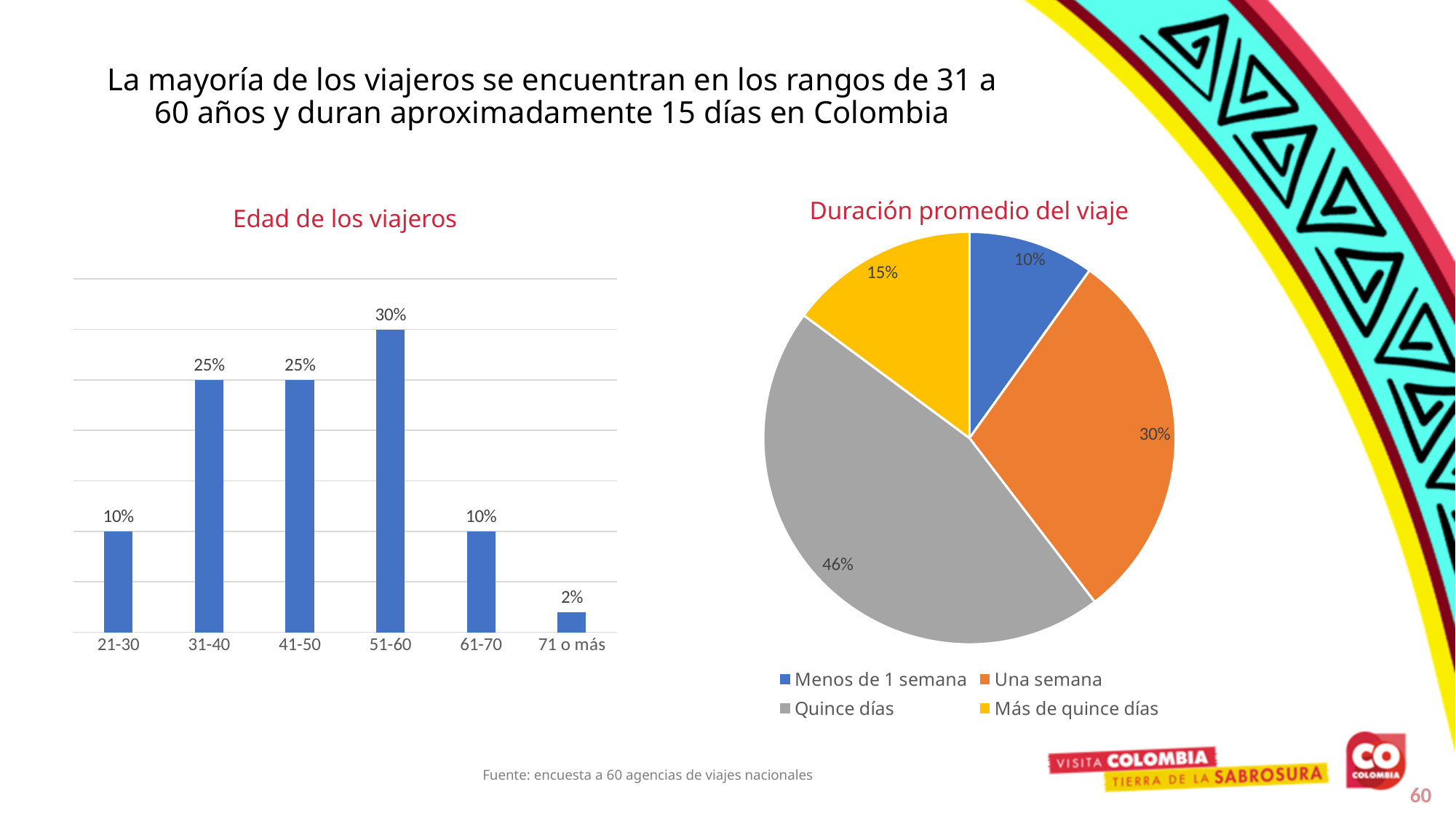
In the 'Duración promedio del viaje' chart, what share of the pie is 'Quince días'? 46% In the 'Edad de los viajeros' chart, what is the difference between the values for 51-60 and 21-30? 20% What type of chart is 'Edad de los viajeros'? Bar chart In the 'Edad de los viajeros' chart, how many age categories are shown on the x axis? 6 In the 'Edad de los viajeros' chart, which age range has the lowest value? 71 o más In the 'Edad de los viajeros' chart, what is the value for the 51-60 age range? 30% In the 'Duración promedio del viaje' chart, which category has the smallest slice? Menos de 1 semana In the 'Edad de los viajeros' chart, what is the value for the '71 o más' category? 2% How many entries does the legend of the 'Duración promedio del viaje' chart list? 4 In the 'Edad de los viajeros' chart, which age range has the highest value? 51-60 In the 'Duración promedio del viaje' chart, what is the value for 'Más de quince días'? 15% In the 'Duración promedio del viaje' chart, which is larger: 'Una semana' or 'Más de quince días'? Una semana